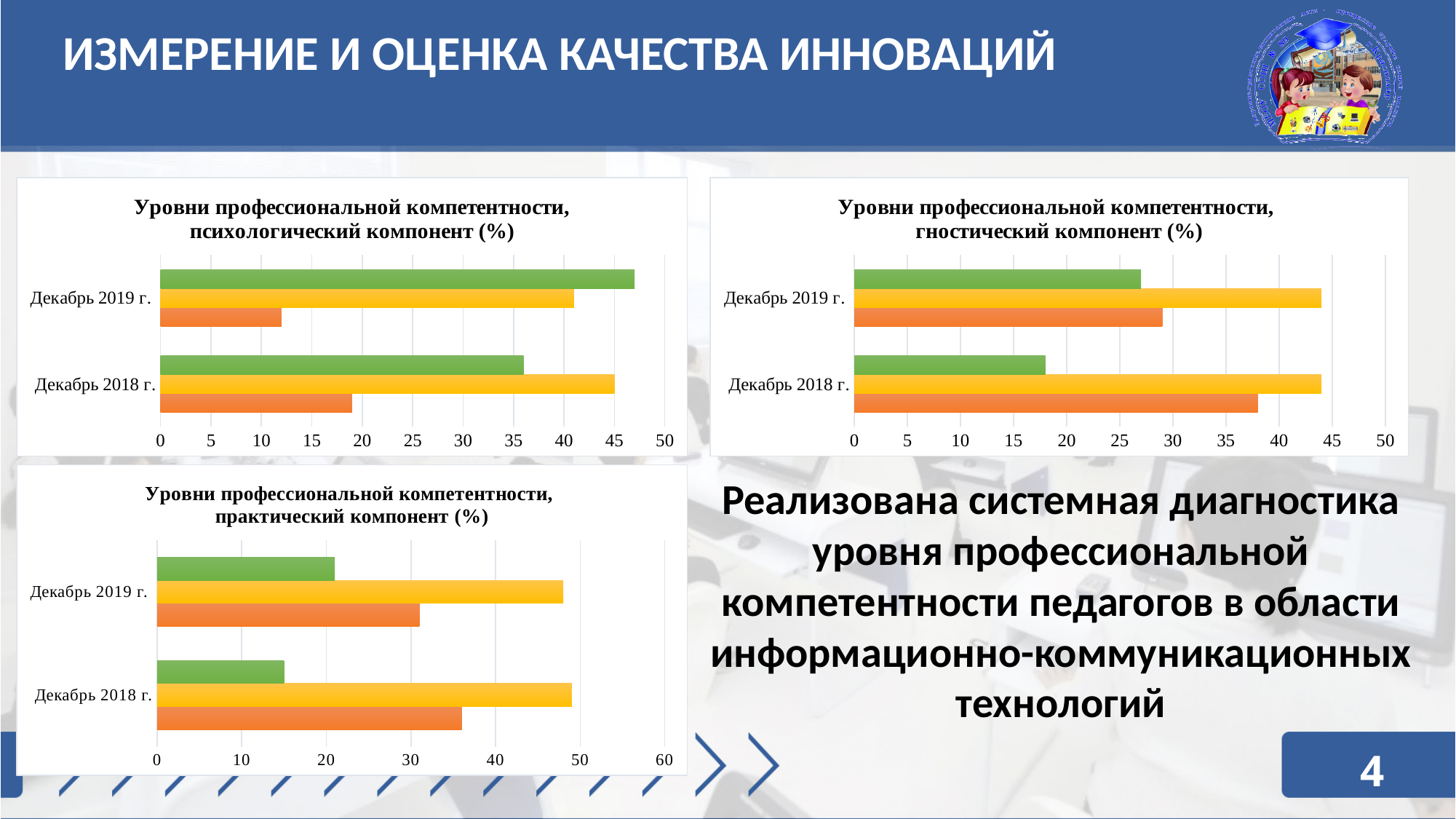
What is the highest value shown on the x axis of the 'практический компонент' chart? 60 What is the title of the chart in the bottom-left of the slide? Уровни профессиональной компетентности, практический компонент (%) In the 'психологический компонент' chart, is the green bar for Декабрь 2019 г. greater or less than 45? greater In the 'практический компонент' chart, is the green bar for Декабрь 2018 г. greater or less than 20? less In the 'практический компонент' chart, which category has the longer green bar, Декабрь 2019 г. or Декабрь 2018 г.? Декабрь 2019 г. In the 'гностический компонент' chart, is the orange bar for Декабрь 2018 г. greater or less than 35? greater In the 'гностический компонент' chart, which category has the longer orange bar, Декабрь 2019 г. or Декабрь 2018 г.? Декабрь 2018 г. In the 'психологический компонент' chart, which category has the longer green bar, Декабрь 2019 г. or Декабрь 2018 г.? Декабрь 2019 г. How many categories are shown on the 'Уровни профессиональной компетентности, гностический компонент (%)' chart? 2 What kind of chart is the 'Уровни профессиональной компетентности, психологический компонент (%)' chart? bar chart